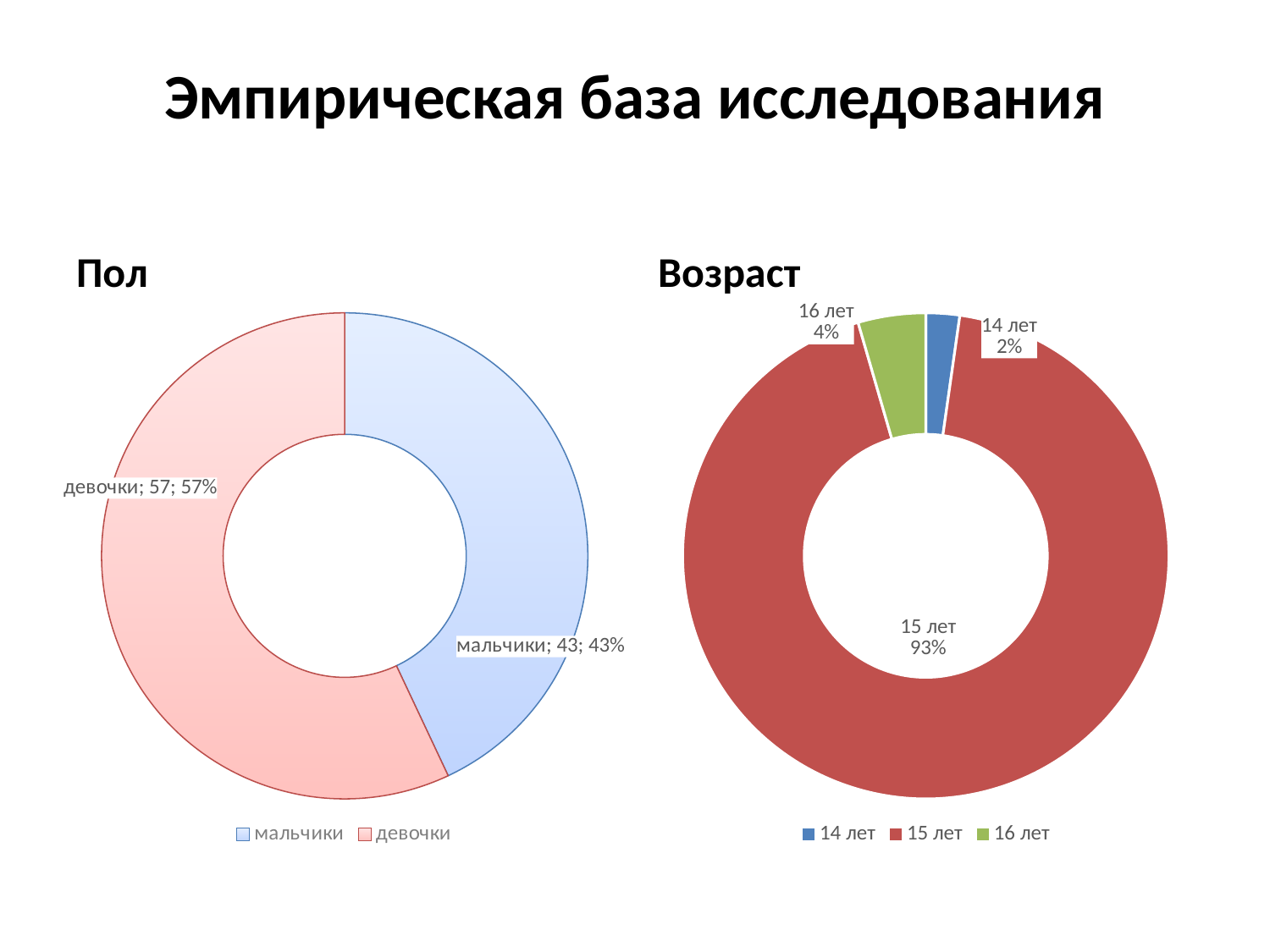
In the "Возраст" chart, what percentage share does 14 лет have? 2% In the "Возраст" chart, how many categories does the legend list? 3 In the "Пол" chart, which category is larger, мальчики or девочки? девочки In the "Пол" chart, what is the total of the two categories? 100 In the "Пол" chart, what is the difference between the values for девочки and мальчики? 14 In the "Пол" chart, what is the value for девочки? 57 What type of chart is the "Возраст" chart? Doughnut (pie) chart In the "Возраст" chart, what percentage share does 15 лет have? 93% In the "Возраст" chart, which category has the smallest share? 14 лет In the "Пол" chart, what percentage share do мальчики have? 43% In the "Пол" chart, how many categories are shown? 2 In the "Возраст" chart, which category has the largest share? 15 лет